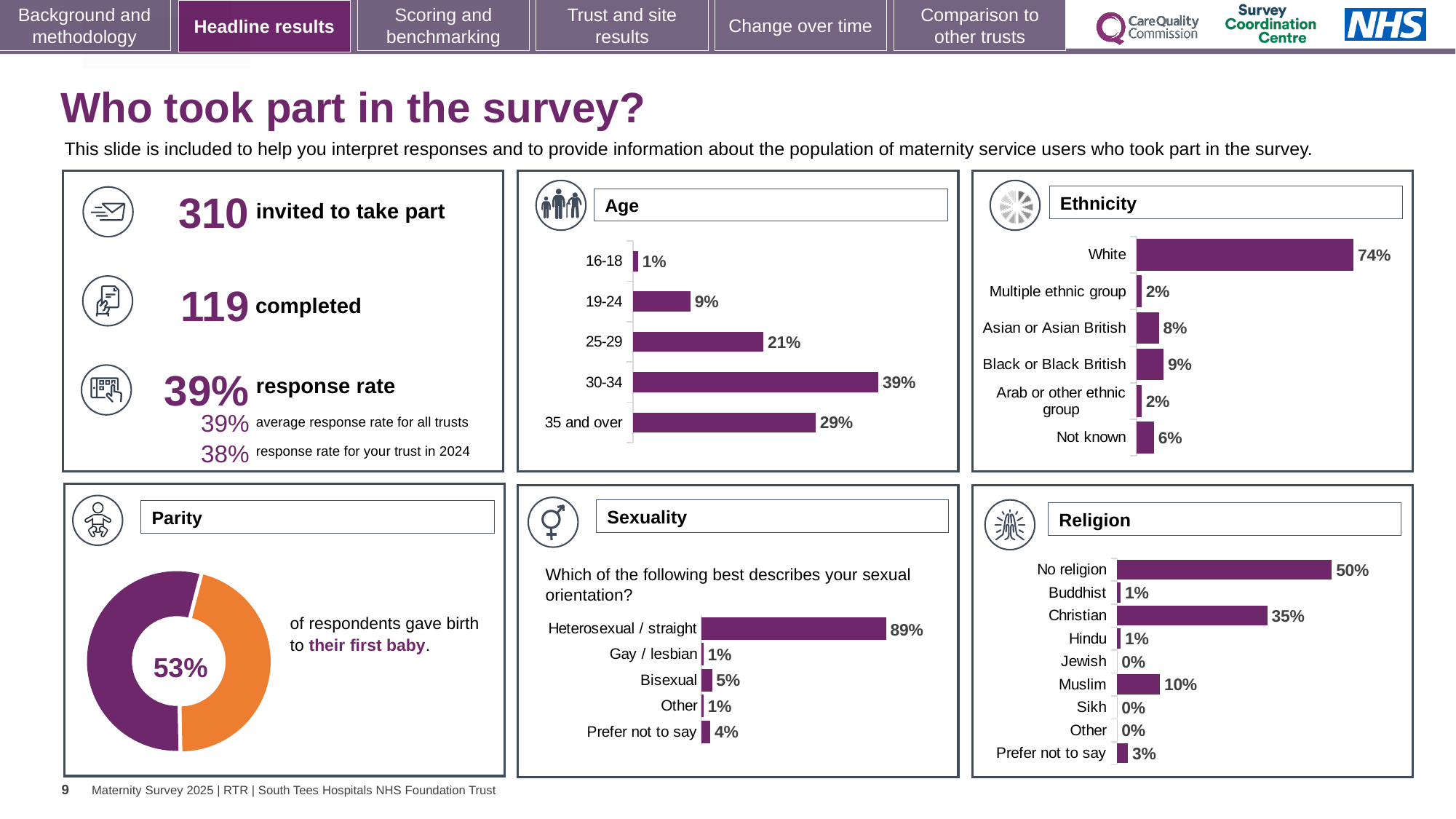
In the Parity chart, what share of respondents gave birth to their first baby? 53% In the Ethnicity chart, what percentage of respondents were White? 74% In the Sexuality chart, which category has the highest percentage? Heterosexual / straight In the Sexuality chart, what percentage of respondents answered Bisexual? 5% What kind of chart is the Parity chart? Doughnut chart In the Religion chart, what is the difference between No religion and Christian? 15% In the Ethnicity chart, how many ethnicity categories are shown? 6 In the Religion chart, what percentage of respondents were Muslim? 10% In the Age chart, what is the difference between the 30-34 and 35 and over percentages? 10% In the Age chart, which age group has the lowest percentage? 16-18 In the Ethnicity chart, which is larger: Asian or Asian British or Black or Black British? Black or Black British In the Age chart, what percentage of respondents were aged 30-34? 39%